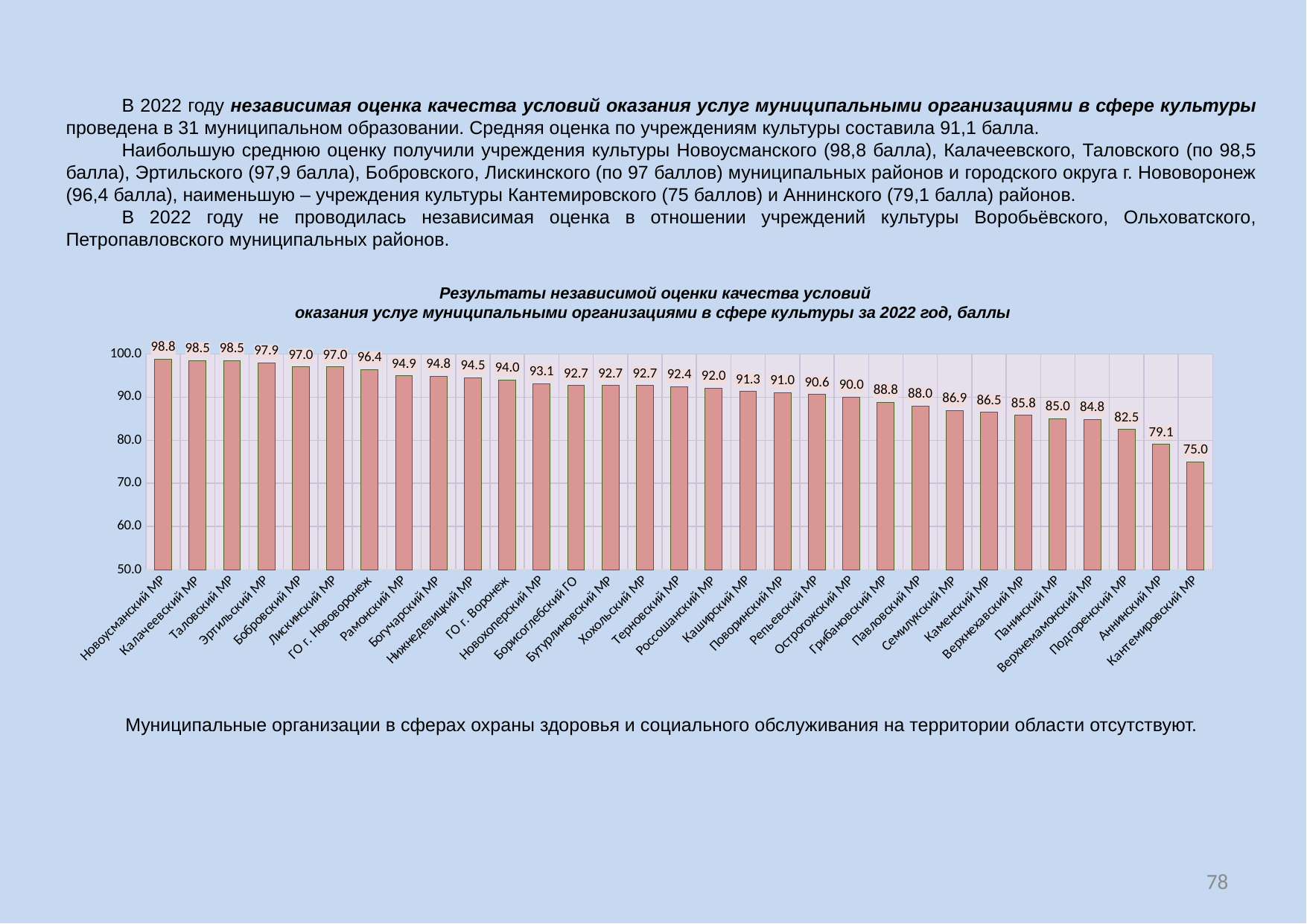
Which category has the lowest value? Кантемировский МР What is the value for Новоусманский МР? 98.8 What is the value for Подгоренский МР? 82.5 How many categories are shown in the chart? 31 Do the values rise or fall from left to right along the x axis? fall Which is larger, the value for Аннинский МР or the value for Панинский МР? Панинский МР What is the value for Острогожский МР? 90.0 What is the difference between the values for Новоусманский МР and Кантемировский МР? 23.8 Which category has the highest value? Новоусманский МР What is the value for ГО г. Воронеж? 94.0 What kind of chart is shown on the slide? bar chart Is the value for Грибановский МР greater or less than 90.0? less